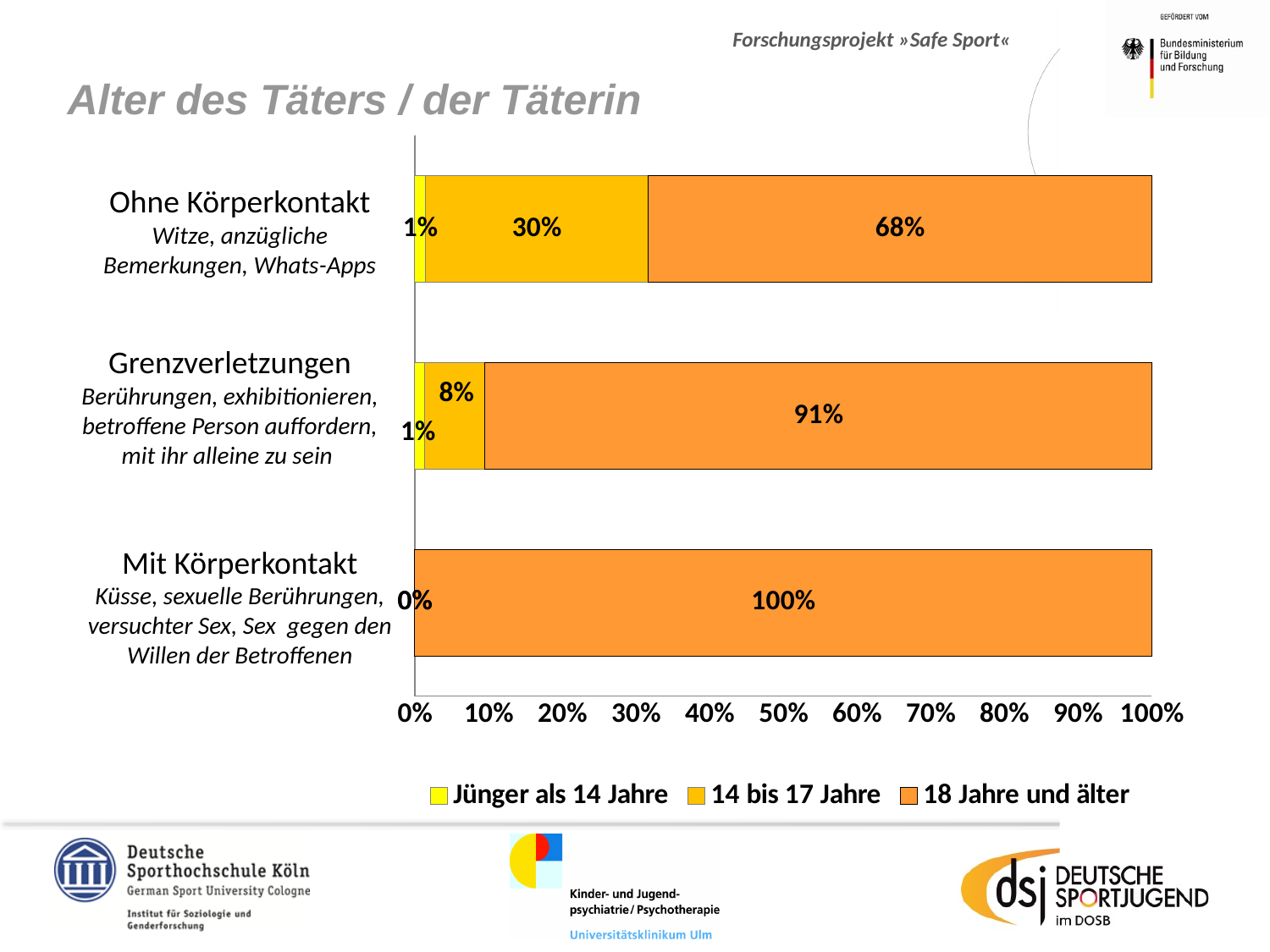
What is the value for '18 Jahre und älter' in the 'Mit Körperkontakt' category? 100% Which category has the highest value for '18 Jahre und älter'? Mit Körperkontakt What is the value for '14 bis 17 Jahre' in the 'Ohne Körperkontakt' category? 30% What is the value for 'Jünger als 14 Jahre' in the 'Grenzverletzungen' category? 1% What is the value for '18 Jahre und älter' in the 'Ohne Körperkontakt' category? 68% What is the difference between the '18 Jahre und älter' values for 'Grenzverletzungen' and 'Ohne Körperkontakt'? 23 percentage points What type of chart is shown on the slide? Stacked bar chart Which category has the lowest value for '18 Jahre und älter'? Ohne Körperkontakt How many categories are shown in the chart? 3 How many series does the legend list? 3 Which category has the larger value for '14 bis 17 Jahre': 'Ohne Körperkontakt' or 'Grenzverletzungen'? Ohne Körperkontakt What is the value for '14 bis 17 Jahre' in the 'Grenzverletzungen' category? 8%